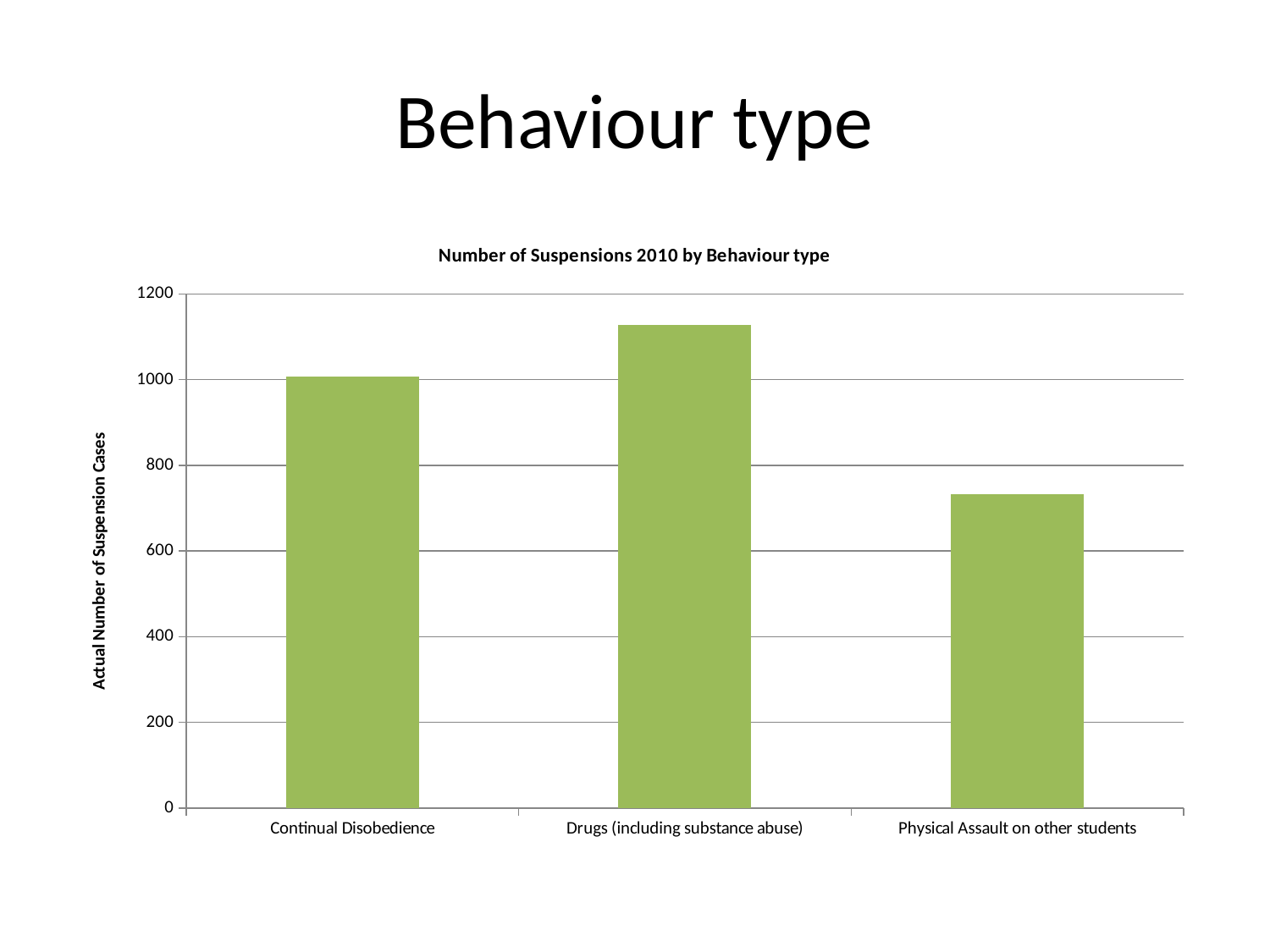
Is the value for Continual Disobedience greater or less than 800? greater What kind of chart is shown on the slide? bar chart Which has more suspensions: Continual Disobedience or Drugs (including substance abuse)? Drugs (including substance abuse) Which behaviour type has the highest number of suspensions? Drugs (including substance abuse) Is the value for Physical Assault on other students greater or less than 600? greater Which behaviour type has the lowest number of suspensions? Physical Assault on other students How many behaviour type categories are plotted in the chart? 3 What is the title of the chart? Number of Suspensions 2010 by Behaviour type What is the label on the vertical axis of the chart? Actual Number of Suspension Cases Which has more suspensions: Continual Disobedience or Physical Assault on other students? Continual Disobedience Is the value for Physical Assault on other students greater or less than 800? less